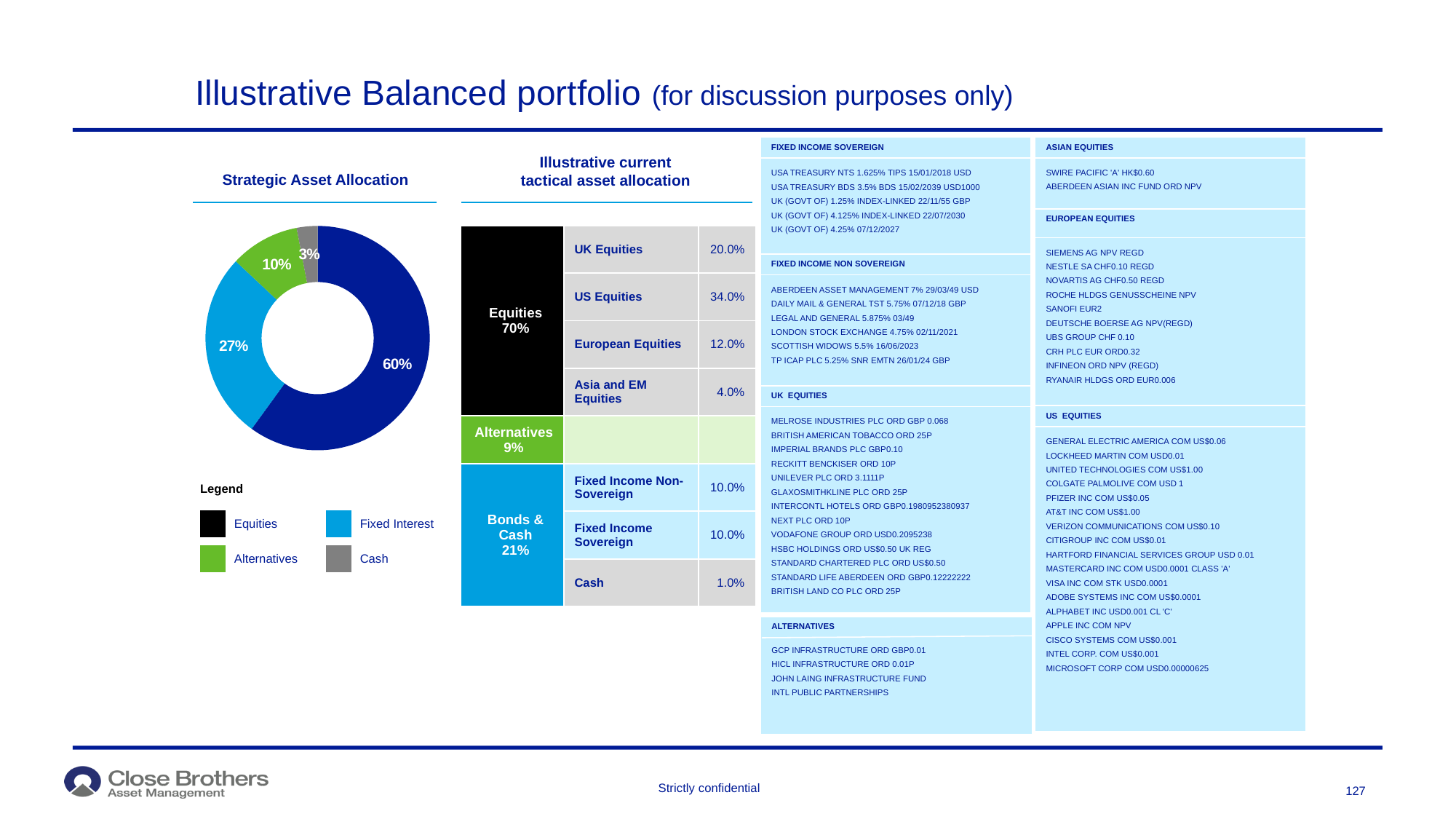
In the Strategic Asset Allocation chart, what is the largest slice's value? 60% What kind of chart is the Strategic Asset Allocation chart? Pie chart (donut) In the Strategic Asset Allocation chart, what share is shown for Alternatives? 10% In the Strategic Asset Allocation chart, what is the difference between the Fixed Interest slice and the Alternatives slice? 17% How many categories does the legend of the Strategic Asset Allocation chart list? 4 In the Strategic Asset Allocation chart, what share is shown for Fixed Interest? 27% What is the title of the pie chart on the left of the slide? Strategic Asset Allocation In the Strategic Asset Allocation chart, which is larger: Alternatives or Cash? Alternatives In the Strategic Asset Allocation chart, what is the combined share of Alternatives and Cash? 13% Which category has the smallest slice in the Strategic Asset Allocation chart? Cash In the Strategic Asset Allocation chart, what share is shown for Cash? 3% How many slices does the Strategic Asset Allocation pie chart have? 4